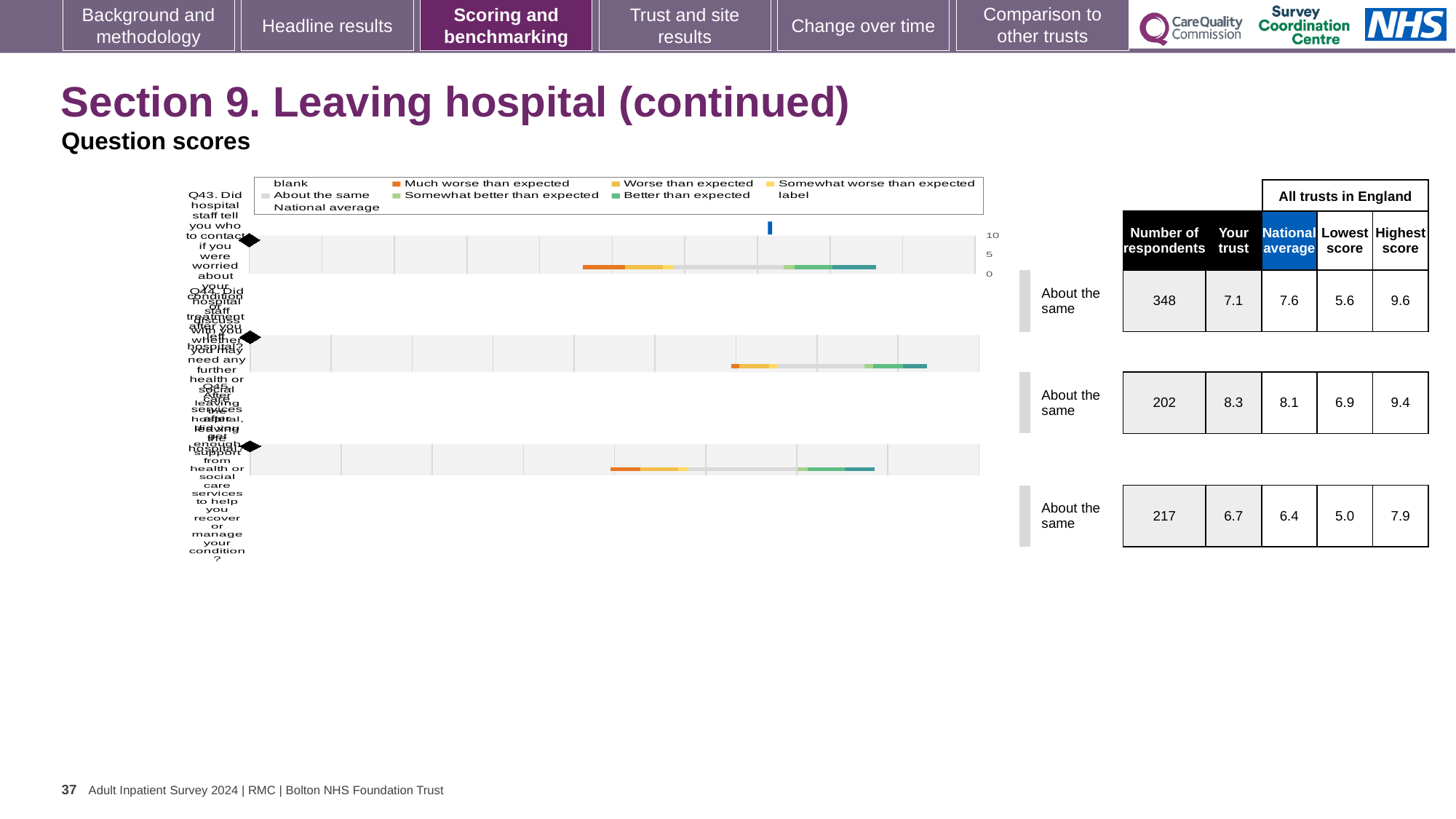
For the top chart (Q43), what is the 'Your trust' score shown in the table beside it? 7.1 What kind of chart is used to show the question scores on this slide? bar chart For the bottom chart, how many respondents are shown in the table beside it? 217 For the top chart (Q43), which is larger: the 'Your trust' score or the national average? National average Which of the three charts has the highest 'Your trust' score in the table? the middle chart For the middle chart, which is larger: the 'Your trust' score or the national average? Your trust What is the highest tick value shown on the score axis of the top chart? 10 What benchmark category label is shown next to each of the three charts? About the same How many question charts are shown on the slide? 3 For the middle chart, what is the national average score shown in the table beside it? 8.1 For the bottom chart, what is the difference between the highest score and the lowest score shown in the table? 2.9